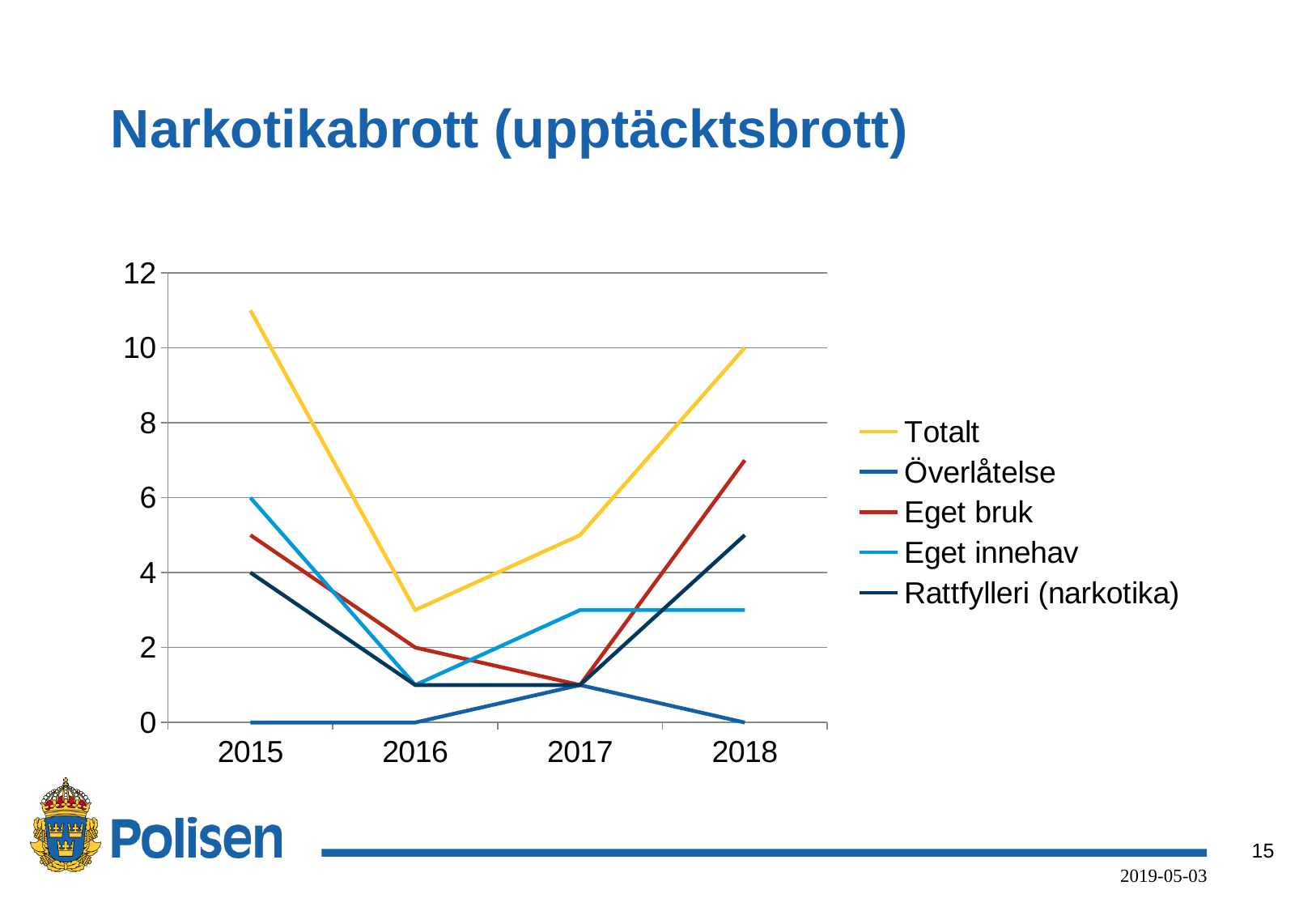
Is the value for Totalt in 2015 greater or less than 10? greater In which year is the Totalt series at its lowest? 2016 What is the value for Rattfylleri (narkotika) in 2015? 4 What is the value for Överlåtelse in 2016? 0 How many years are shown on the x axis? 4 What is the value for Eget innehav in 2015? 6 What type of chart is shown on the slide? line chart Does the Totalt series rise or fall from 2016 to 2018? rise How many series does the legend list? 5 What is the value for Totalt in 2018? 10 In 2018, which is larger: Eget bruk or Rattfylleri (narkotika)? Eget bruk In which year is the Totalt series at its highest? 2015